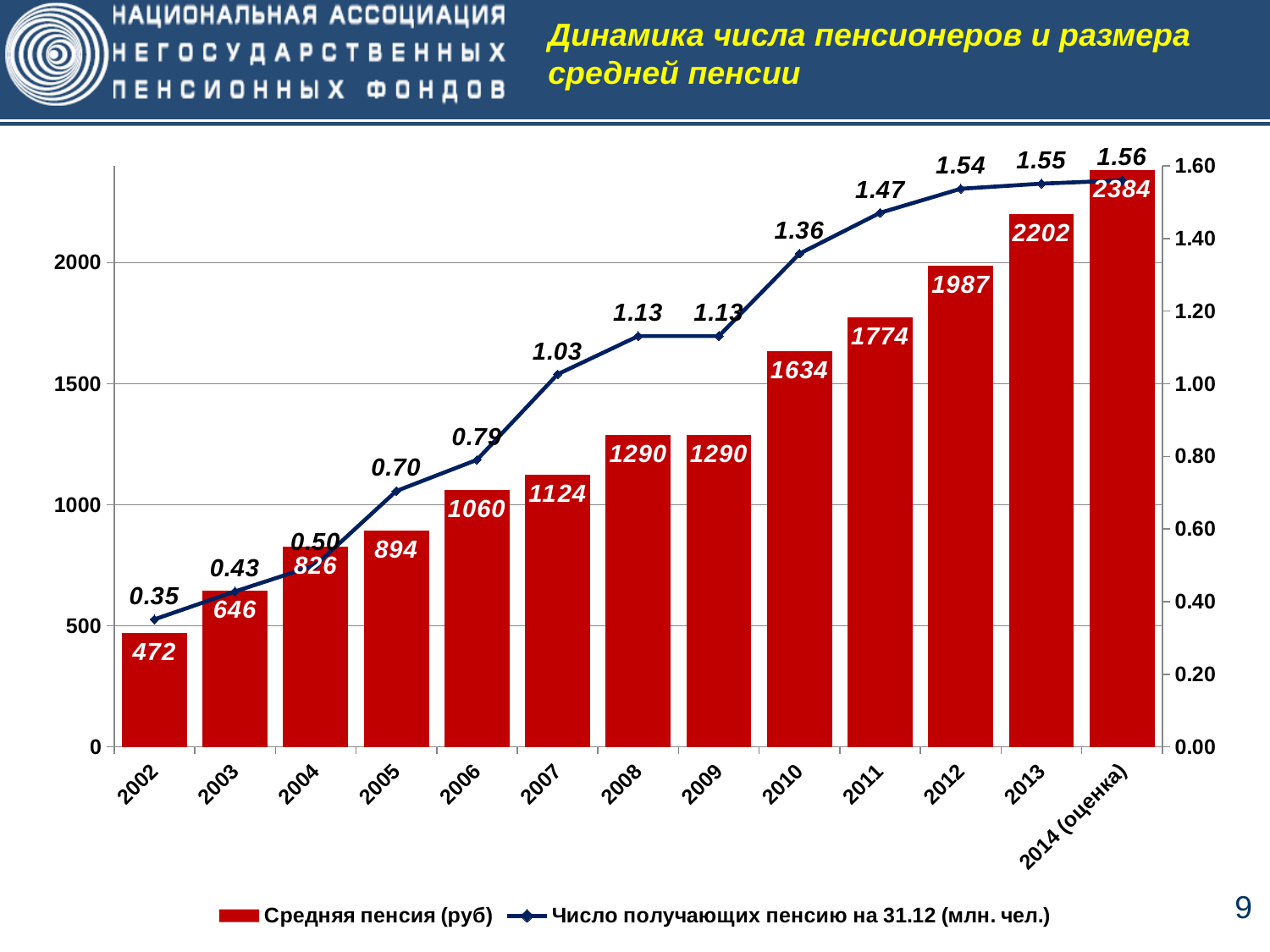
Does the "Средняя пенсия (руб)" series rise or fall from 2002 to 2014 (оценка)? rise What is the difference between the "Число получающих пенсию на 31.12 (млн. чел.)" values for 2010 and 2009? 0.23 How many categories are shown on the x axis? 13 How many series does the legend list? 2 Which category has the highest value for "Число получающих пенсию на 31.12 (млн. чел.)"? 2014 (оценка) What is the value of the "Средняя пенсия (руб)" bar for 2010? 1634 What colour are the "Средняя пенсия (руб)" bars? red Which is larger, the "Средняя пенсия (руб)" value for 2005 or for 2006? 2006 What is the difference between the "Средняя пенсия (руб)" values for 2013 and 2012? 215 Which year has the lowest value for "Средняя пенсия (руб)"? 2002 What is the value of the "Средняя пенсия (руб)" bar for 2014 (оценка)? 2384 What is the value of the "Число получающих пенсию на 31.12 (млн. чел.)" line for 2007? 1.03